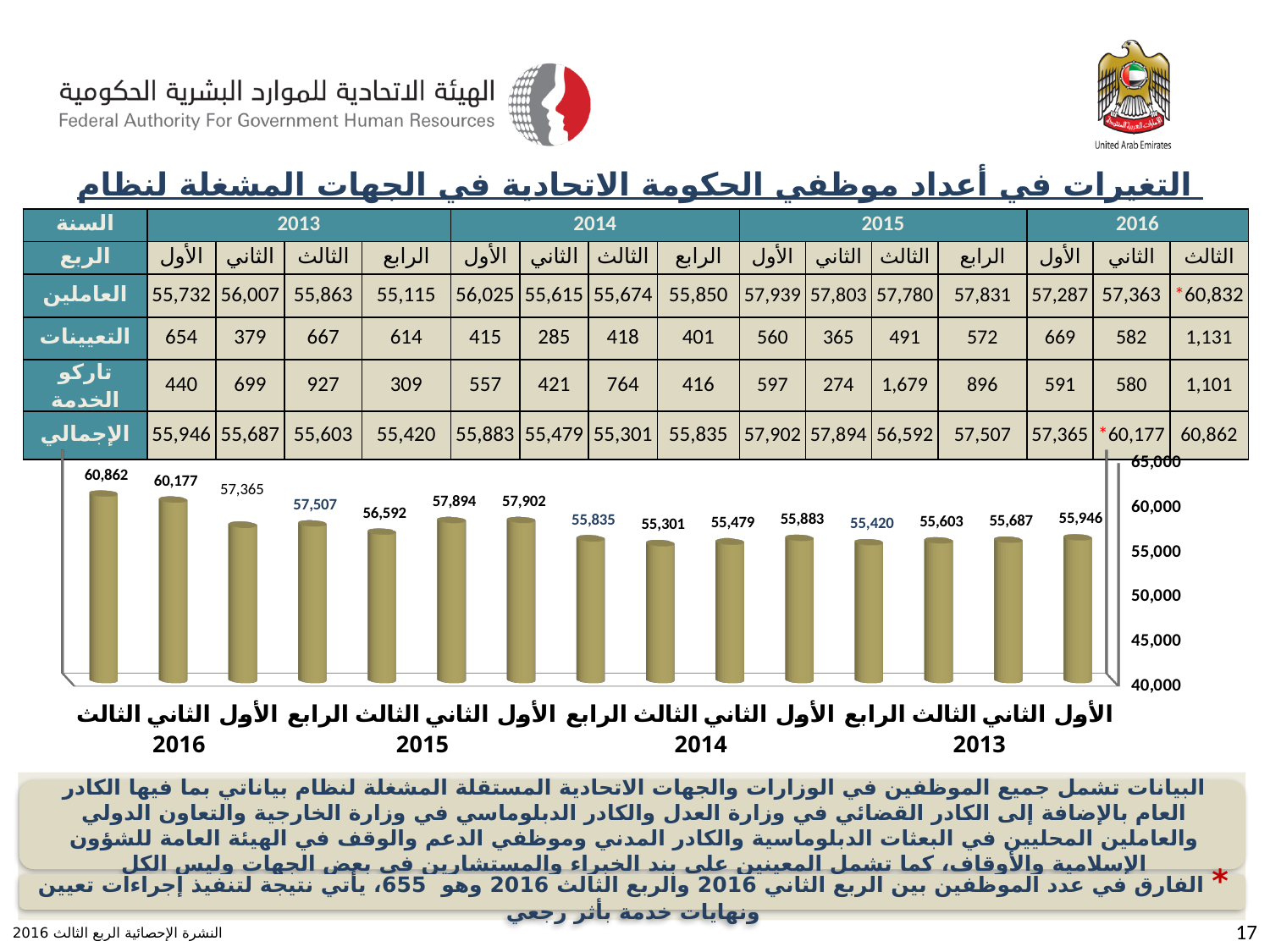
Which quarter has the highest bar in the chart? الثالث 2016 What is the value of the bar for the third quarter (الثالث) of 2015? 56,592 Which quarter has the lowest bar in the chart? الثالث 2014 Which is larger: the bar for the fourth quarter (الرابع) of 2015 or the bar for the first quarter (الأول) of 2016? الرابع 2015 Is the value for the fourth quarter (الرابع) of 2013 greater or less than 60,000? less What is the difference between the bars for the third quarter of 2016 (60,862) and the second quarter of 2016 (60,177)? 685 What type of chart is shown on the slide? bar chart What is the value of the bar for the first quarter (الأول) of 2013? 55,946 Is the value for the second quarter (الثاني) of 2016 greater or less than 60,000? greater What is the value of the bar for the third quarter (الثالث) of 2016? 60,862 How many bars are plotted in the chart? 15 What is the highest value shown on the chart's vertical axis? 65,000